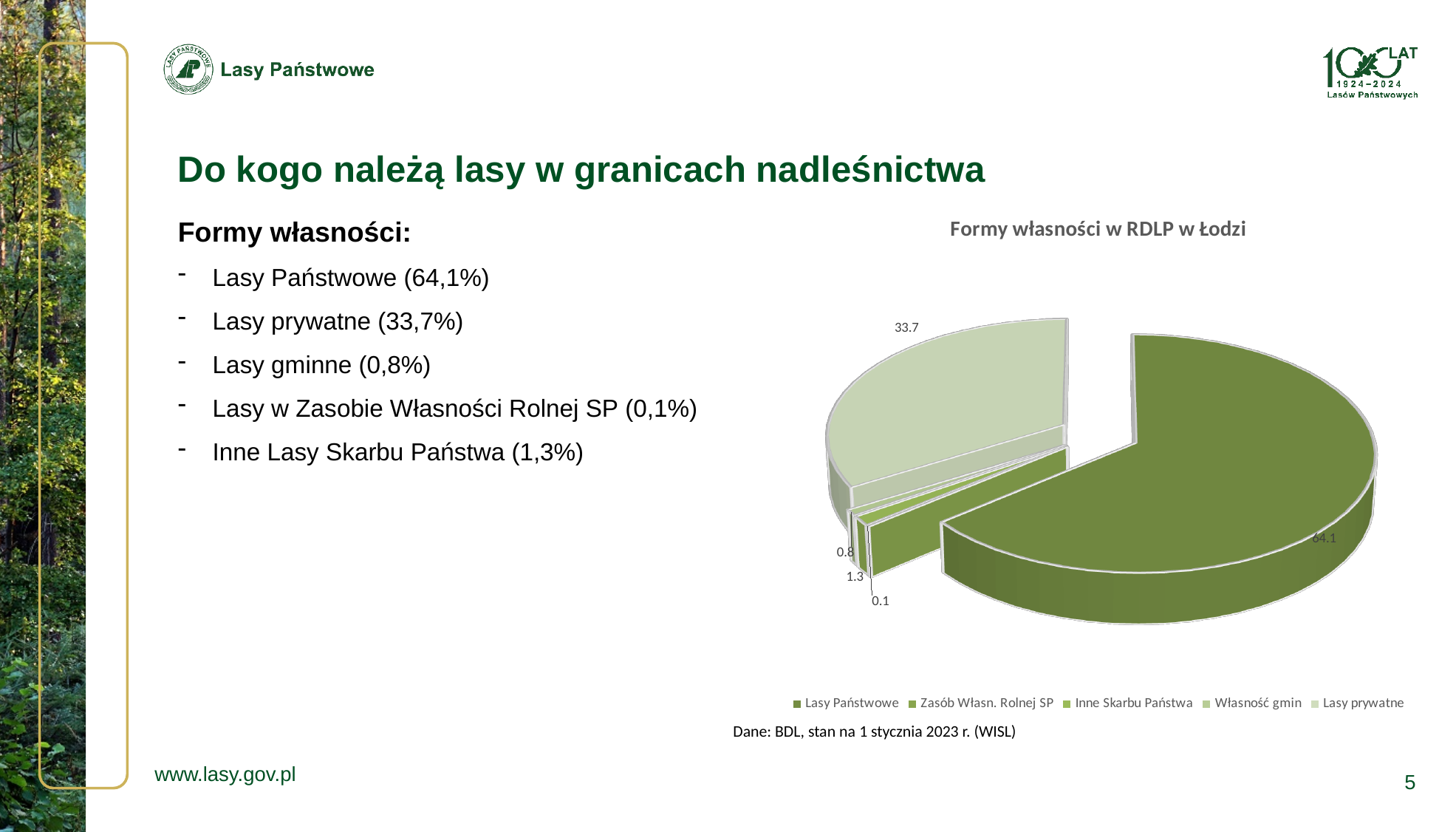
Which category has the smallest slice of the pie? Zasób Własn. Rolnej SP What kind of chart is shown on the slide? pie chart What value is shown for the Własność gmin slice? 0.8 What value is shown for the Lasy prywatne slice? 33.7 What is the title of the chart? Formy własności w RDLP w Łodzi Which category has the largest slice of the pie? Lasy Państwowe How many slices does the pie chart have? 5 What value is shown for the Zasób Własn. Rolnej SP slice? 0.1 What value is shown for the Lasy Państwowe slice? 64.1 What is the difference between the Lasy Państwowe value and the Lasy prywatne value? 30.4 How many entries does the chart legend list? 5 What value is shown for the Inne Skarbu Państwa slice? 1.3